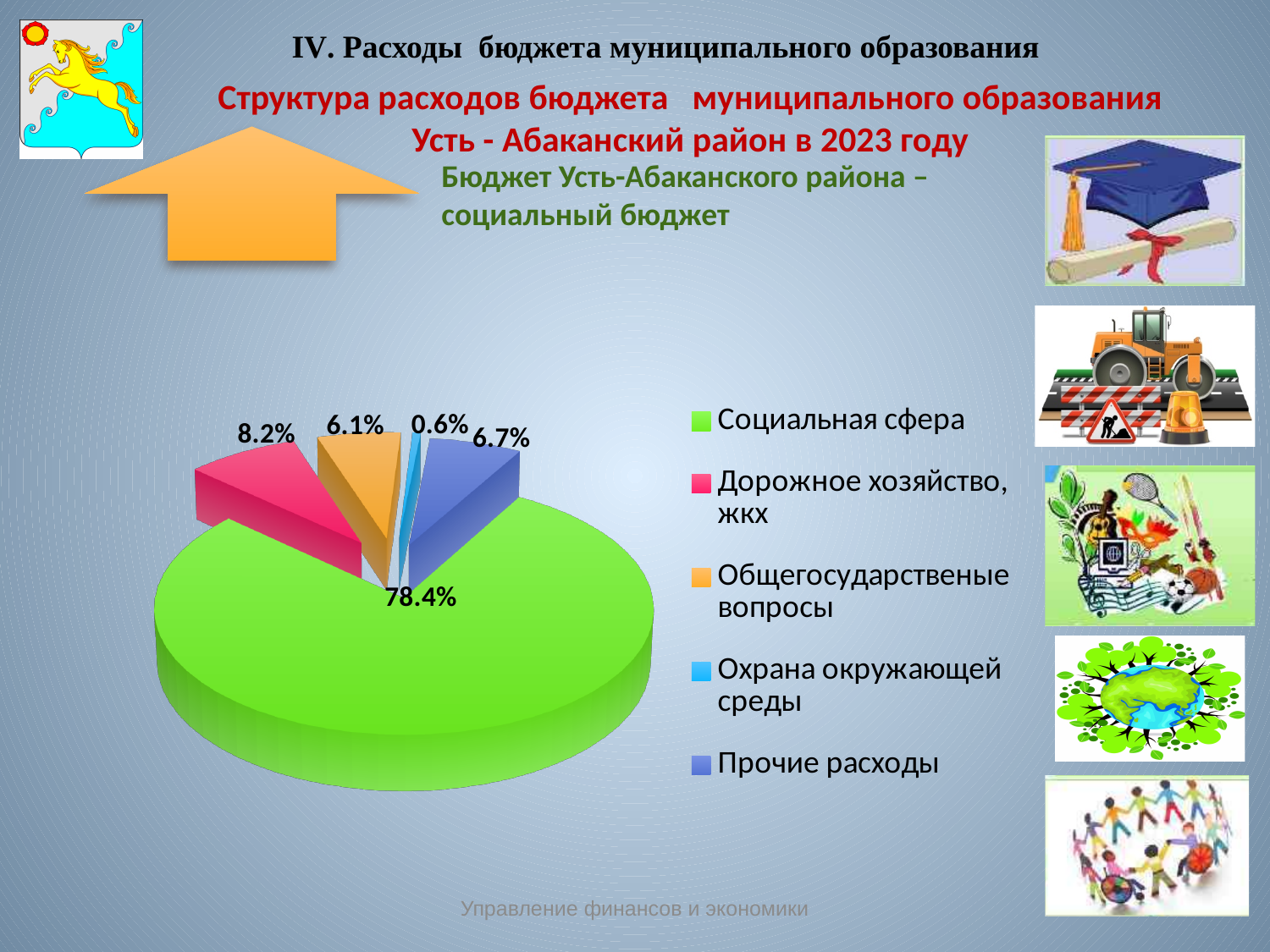
What share of the budget expenditure goes to Социальная сфера? 78.4% What is the value for Прочие расходы? 6.7% Which category has the smallest share of the pie? Охрана окружающей среды How many categories does the pie chart show? 5 What colour is the slice for Социальная сфера? Green Which is larger: the share of Прочие расходы or the share of Общегосударственые вопросы? Прочие расходы Which category has the largest share of the pie? Социальная сфера What is the value for Общегосударственые вопросы? 6.1% What kind of chart is shown on the slide? Pie chart What is the value for Охрана окружающей среды? 0.6% What is the difference between the shares of Дорожное хозяйство, жкх and Прочие расходы? 1.5% What is the value for Дорожное хозяйство, жкх? 8.2%